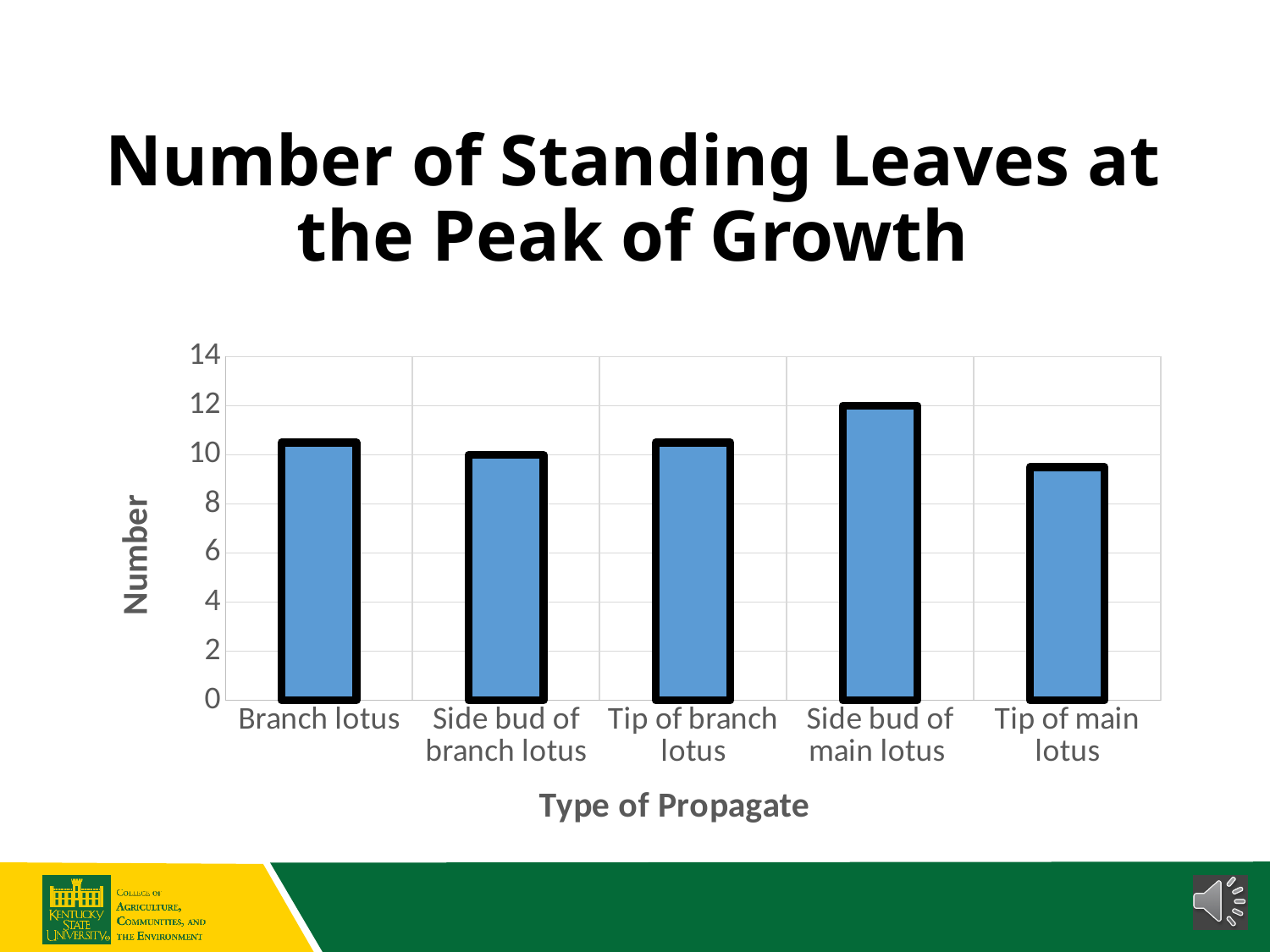
What is the number of standing leaves for Side bud of main lotus? 12 Which type of propagate has the highest number of standing leaves? Side bud of main lotus What is the title of the x axis? Type of Propagate Is the value for Branch lotus greater or less than 12? less Is the value for Tip of main lotus greater or less than 10? less Which type of propagate has the lowest number of standing leaves? Tip of main lotus Is the value for Tip of branch lotus greater or less than 8? greater What is the title of the y axis? Number What kind of chart is shown on the slide? bar chart What is the number of standing leaves for Side bud of branch lotus? 10 Which has more standing leaves, Side bud of main lotus or Tip of main lotus? Side bud of main lotus How many types of propagate are shown on the x axis? 5